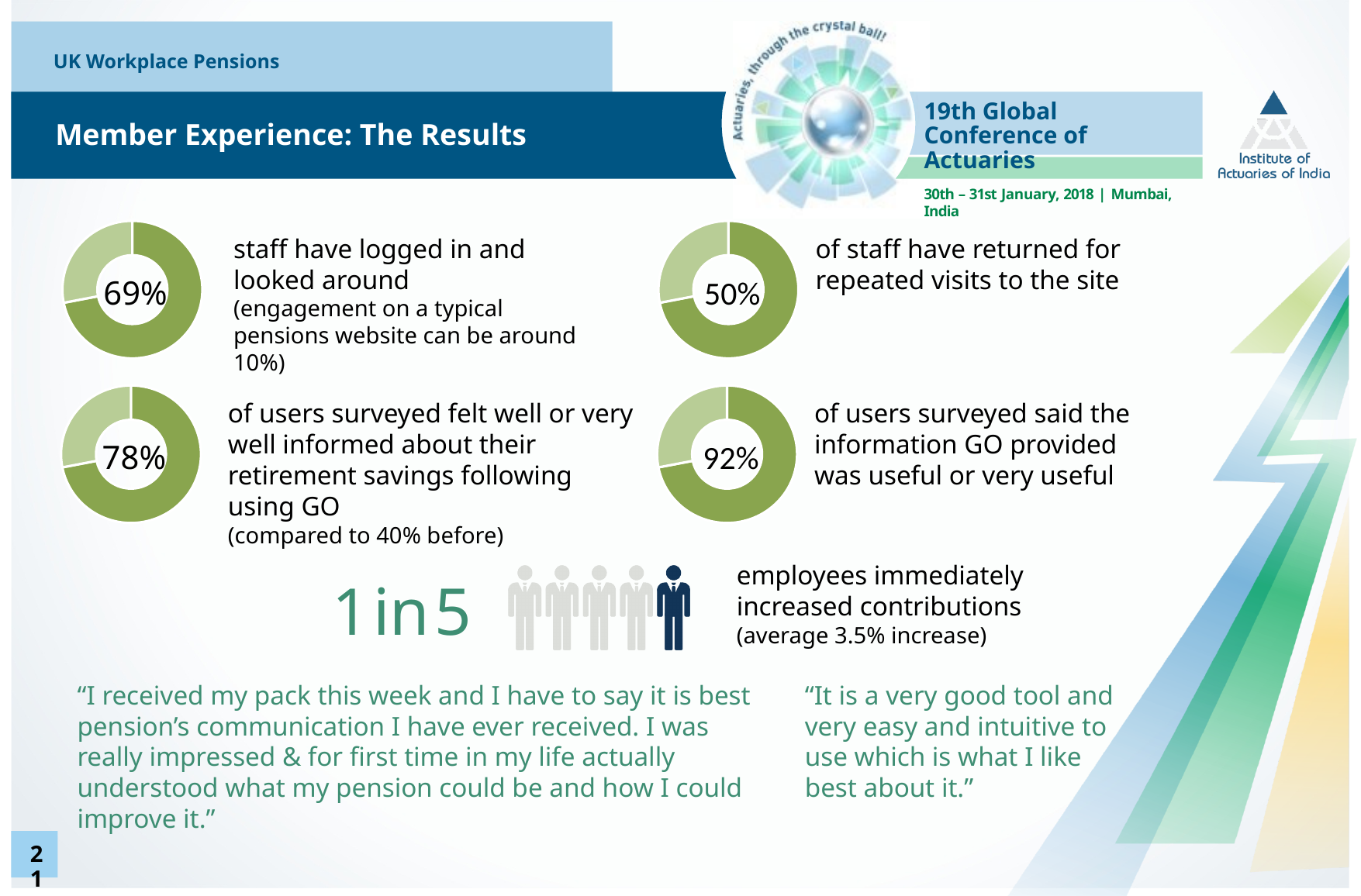
What percentage is shown in the top-left donut chart for staff who have logged in and looked around? 69% What kind of chart is used to display the 69%, 50%, 78% and 92% figures? Donut chart Which of the four donut charts shows the lowest percentage? 50% (staff returned for repeated visits) Which is larger: the percentage of staff who logged in and looked around, or the percentage of staff who returned for repeated visits? Staff who logged in and looked around (69%) What percentage is shown in the top-right donut chart for staff who have returned for repeated visits to the site? 50% According to the pictogram of people, what proportion of employees immediately increased contributions? 1 in 5 What is the difference between the percentage in the top-left donut chart (69%) and the top-right donut chart (50%)? 19 percentage points How many donut charts are shown on the slide? 4 Which of the four donut charts shows the highest percentage? 92% (information GO provided was useful or very useful) What is the difference between the percentage in the bottom-right donut chart (92%) and the bottom-left donut chart (78%)? 14 percentage points What percentage is shown in the bottom-right donut chart for users who said the information GO provided was useful or very useful? 92% What percentage is shown in the bottom-left donut chart for users who felt well or very well informed about their retirement savings after using GO? 78%